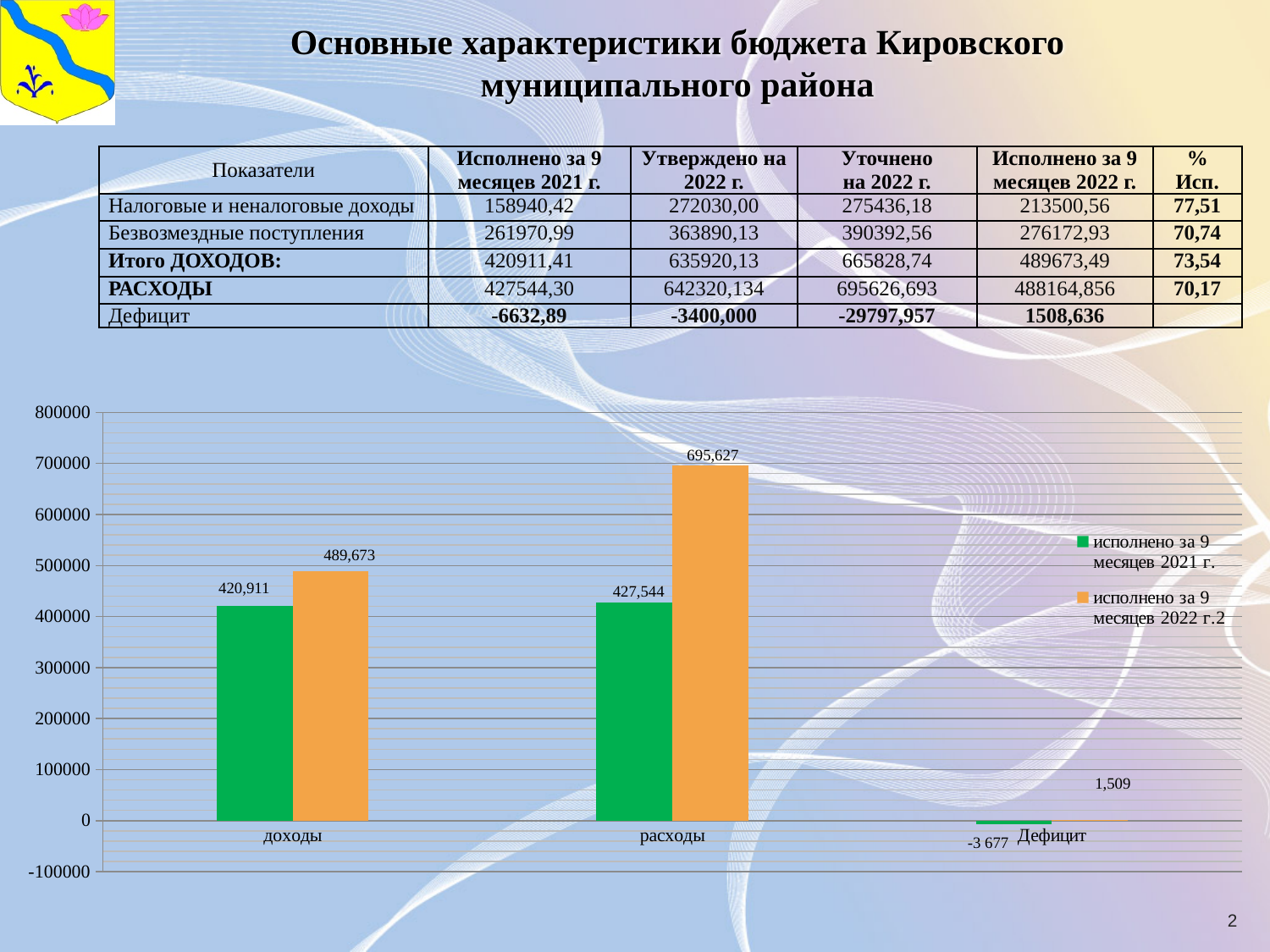
What is the value for Дефицит in the series исполнено за 9 месяцев 2022 г.2? 1,509 For доходы, which series has the larger value: исполнено за 9 месяцев 2021 г. or исполнено за 9 месяцев 2022 г.2? исполнено за 9 месяцев 2022 г.2 How many series does the chart legend list? 2 What is the value for доходы in the series исполнено за 9 месяцев 2021 г.? 420,911 What is the difference between the 2022 and 2021 values for расходы? 268,083 What is the value for расходы in the series исполнено за 9 месяцев 2021 г.? 427,544 What is the value for расходы in the series исполнено за 9 месяцев 2022 г.2? 695,627 Which category has the lowest value in the series исполнено за 9 месяцев 2021 г.? Дефицит How many categories are shown on the x axis of the chart? 3 What kind of chart is shown on the slide? bar chart What is the value for доходы in the series исполнено за 9 месяцев 2022 г.2? 489,673 Which category has the highest value in the series исполнено за 9 месяцев 2022 г.2? расходы